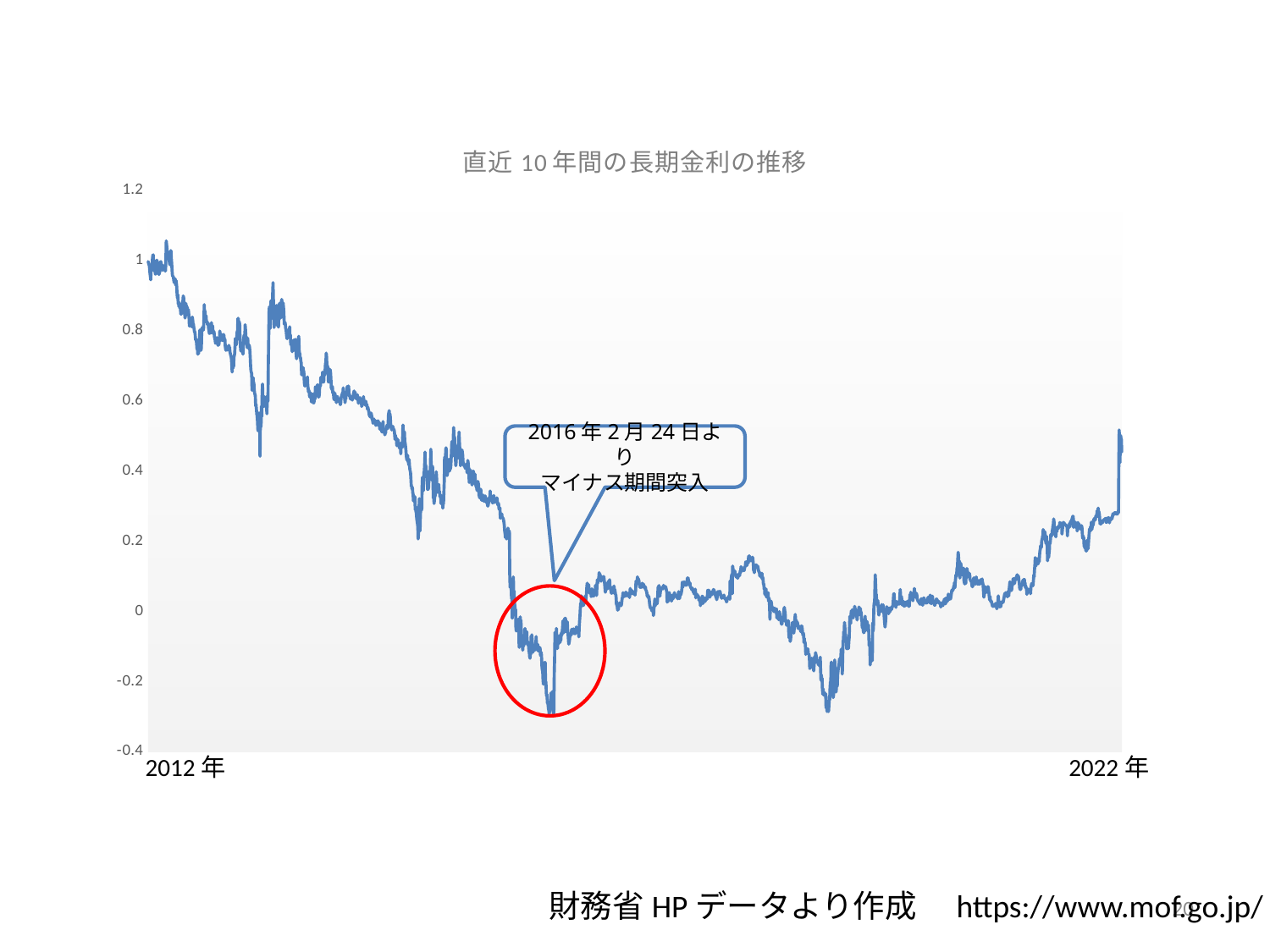
What kind of chart is shown on the slide? line chart Is the lowest point of the line, inside the red circle, greater or less than -0.2? less What is the lowest value shown on the vertical axis? -0.4 What is the highest value shown on the vertical axis? 1.2 What is the title of the chart? 直近10年間の長期金利の推移 Overall, does the long-term interest rate rise or fall from 2012 to 2022 in the chart? fall Is the value at the very end of the chart in 2022 greater or less than 0.2? greater According to the annotation, on what date did the negative-rate period begin? 2016年2月24日 Which years are labelled at the left and right ends of the horizontal axis? 2012年 and 2022年